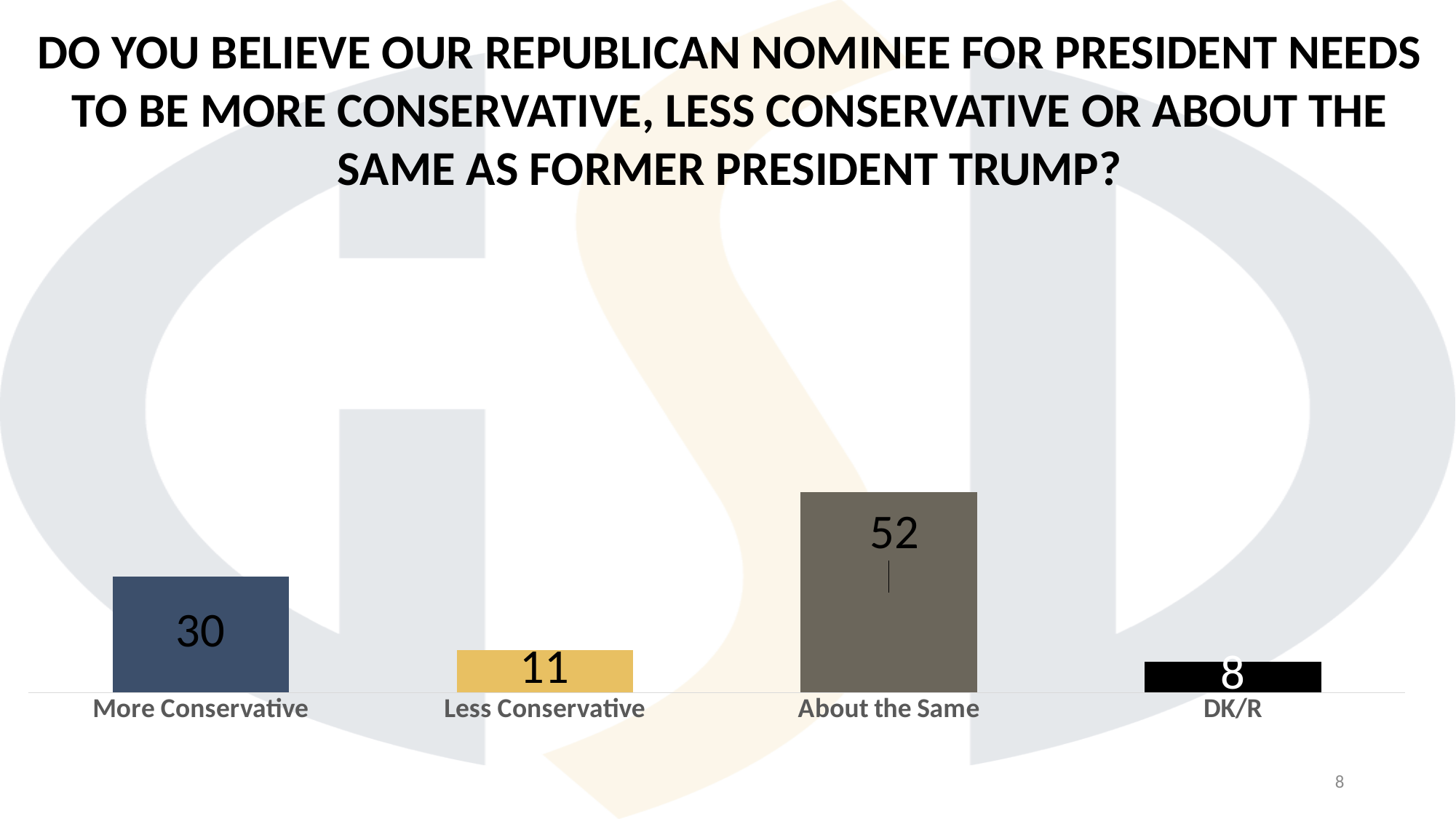
Which category has the highest value? About the Same What is the difference between the values for More Conservative and Less Conservative? 19 What colour is the bar for Less Conservative? Yellow What is the difference between the values for About the Same and More Conservative? 22 What kind of chart is shown on the slide? Bar chart What is the value for About the Same? 52 What is the value for More Conservative? 30 What is the value for DK/R? 8 Which category has the lowest value? DK/R What is the value for Less Conservative? 11 How many categories are shown in the chart? 4 Which is larger, the value for Less Conservative or the value for DK/R? Less Conservative